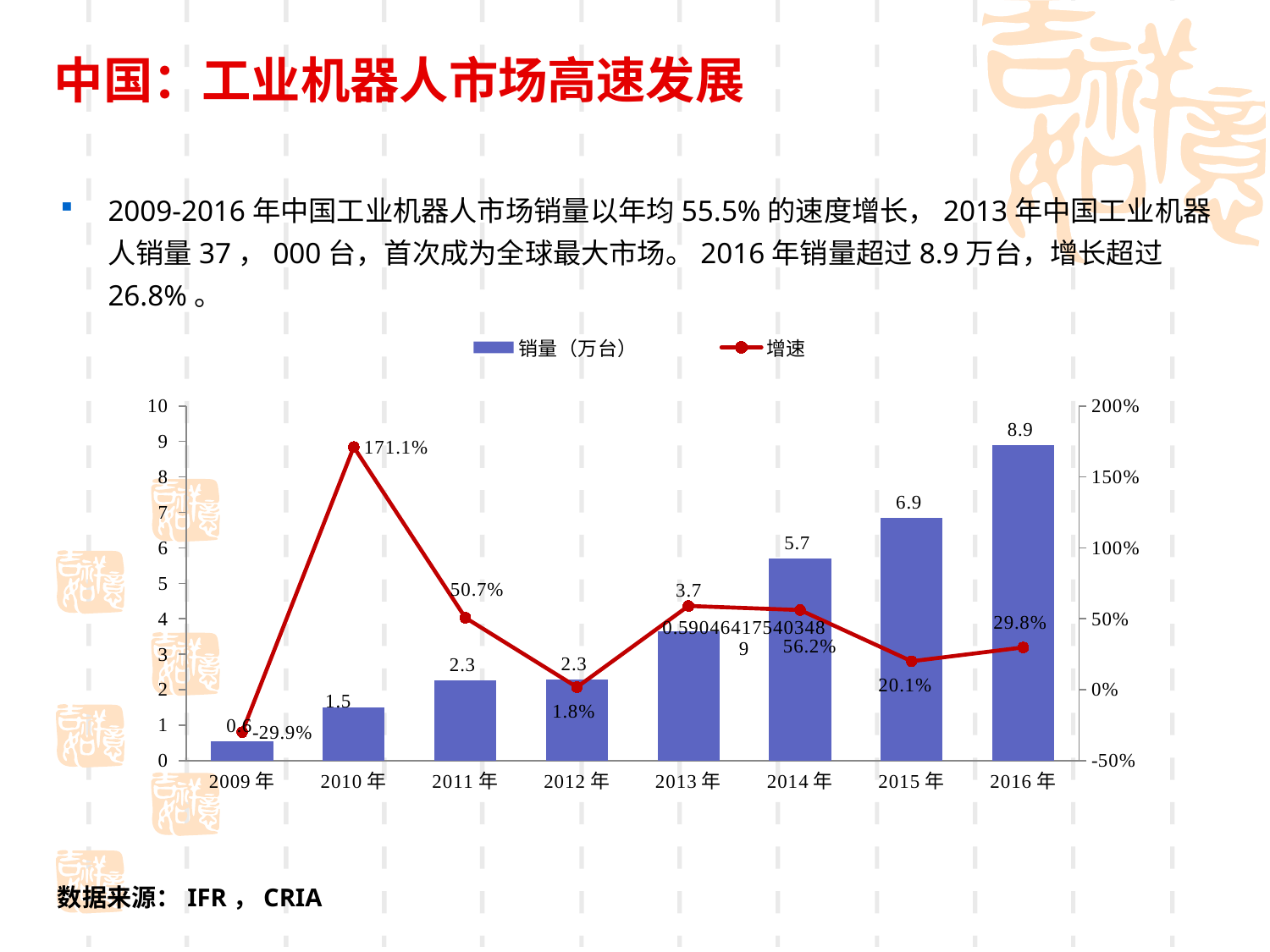
What is the growth rate (增速) for 2012年? 1.8% Which year has the lowest growth rate (增速)? 2009年 Which year has the highest sales volume (销量)? 2016年 Which year has the highest growth rate (增速)? 2010年 How many series does the chart legend list? 2 What is the growth rate (增速) for 2010年? 171.1% What is the sales volume (销量, 万台) for 2016年? 8.9 How many years are shown on the x axis of the chart? 8 What is the difference in sales volume (销量) between 2016年 and 2015年? 2.0 What is the growth rate (增速) for 2015年? 20.1% What is the sales volume (销量, 万台) for 2014年? 5.7 Which year has the larger growth rate (增速), 2014年 or 2015年? 2014年